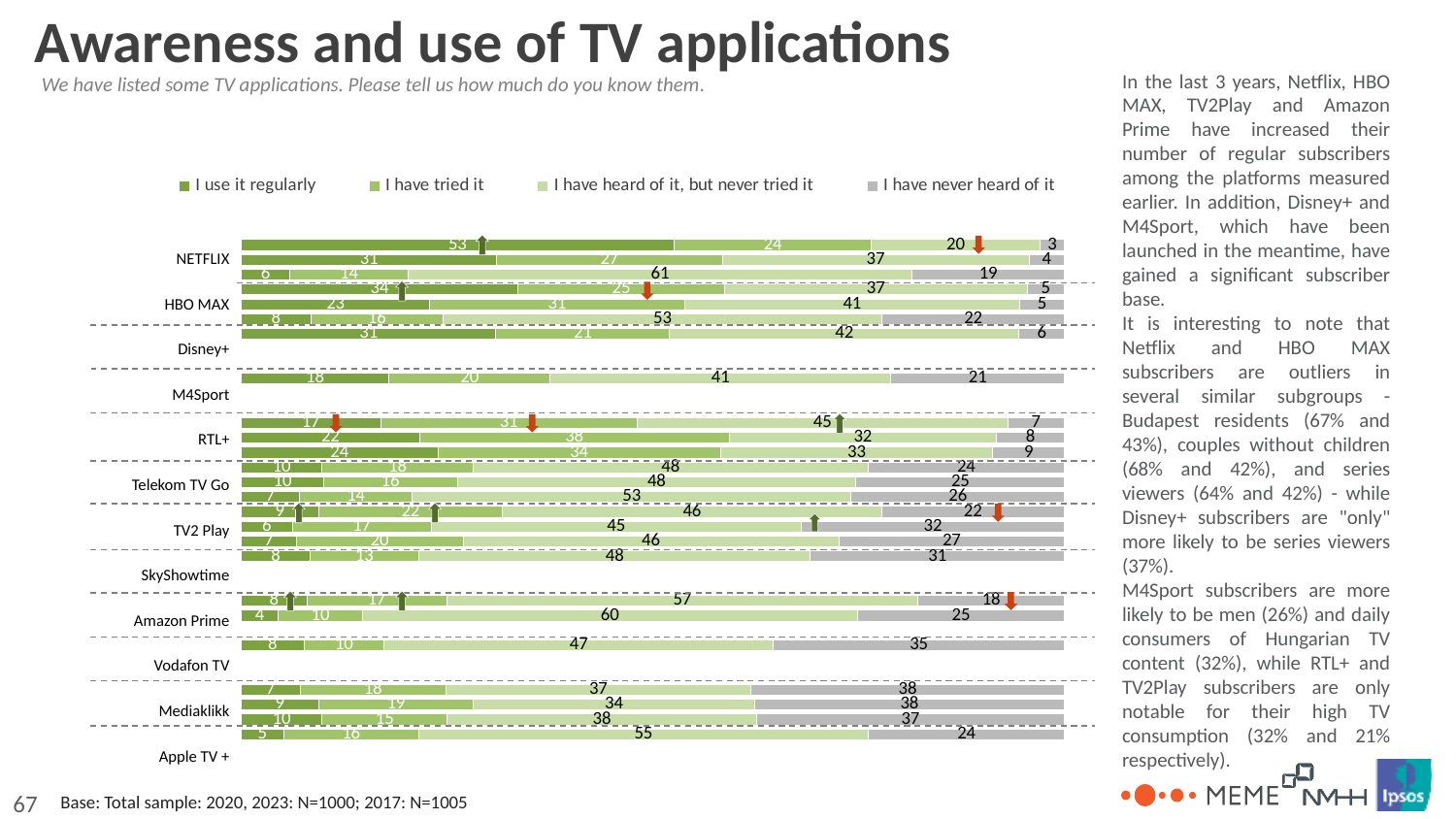
In the top NETFLIX bar, which is larger: 'I use it regularly' or 'I have tried it'? I use it regularly How many TV applications (categories) are listed on the chart? 12 Which legend entry is shown in grey? I have never heard of it For M4Sport, what is the value for 'I have heard of it, but never tried it'? 41 What kind of chart is shown on the slide? Stacked bar chart In the top NETFLIX bar, what is the value for 'I use it regularly'? 53 What is the first legend entry on the chart? I use it regularly For Apple TV +, what is the value for 'I have never heard of it'? 24 For Apple TV +, what is the value for 'I have heard of it, but never tried it'? 55 How many series does the legend list? 4 In the top NETFLIX bar, what is the value for 'I have heard of it, but never tried it'? 20 In the top NETFLIX bar, what is the value for 'I have never heard of it'? 3